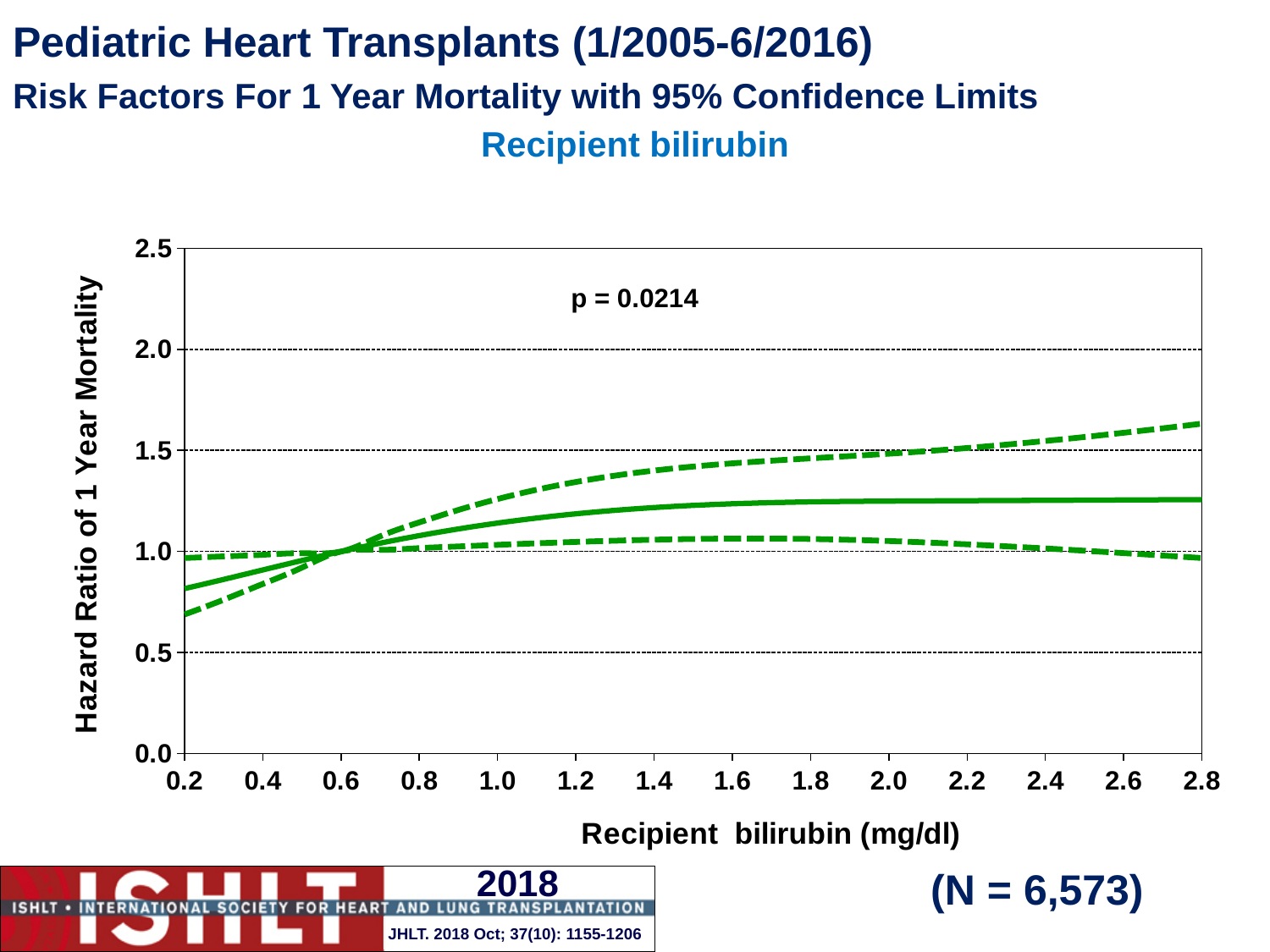
Does the upper dashed confidence limit rise or fall as recipient bilirubin increases along the x axis? rise Is the solid hazard ratio line at a recipient bilirubin of 0.2 mg/dl greater or less than 1.0? less What is the sample size (N) shown on the slide? 6,573 Does the solid hazard ratio line rise or fall as recipient bilirubin increases from 0.2 to 2.8 mg/dl? rise What is the p-value printed on the chart? p = 0.0214 Is the lower dashed confidence limit at a recipient bilirubin of 0.2 mg/dl greater or less than 1.0? less Is the upper dashed confidence limit at a recipient bilirubin of 1.0 mg/dl greater or less than 1.0? greater What kind of chart is shown on the slide? line chart How many lines are plotted on the chart? 3